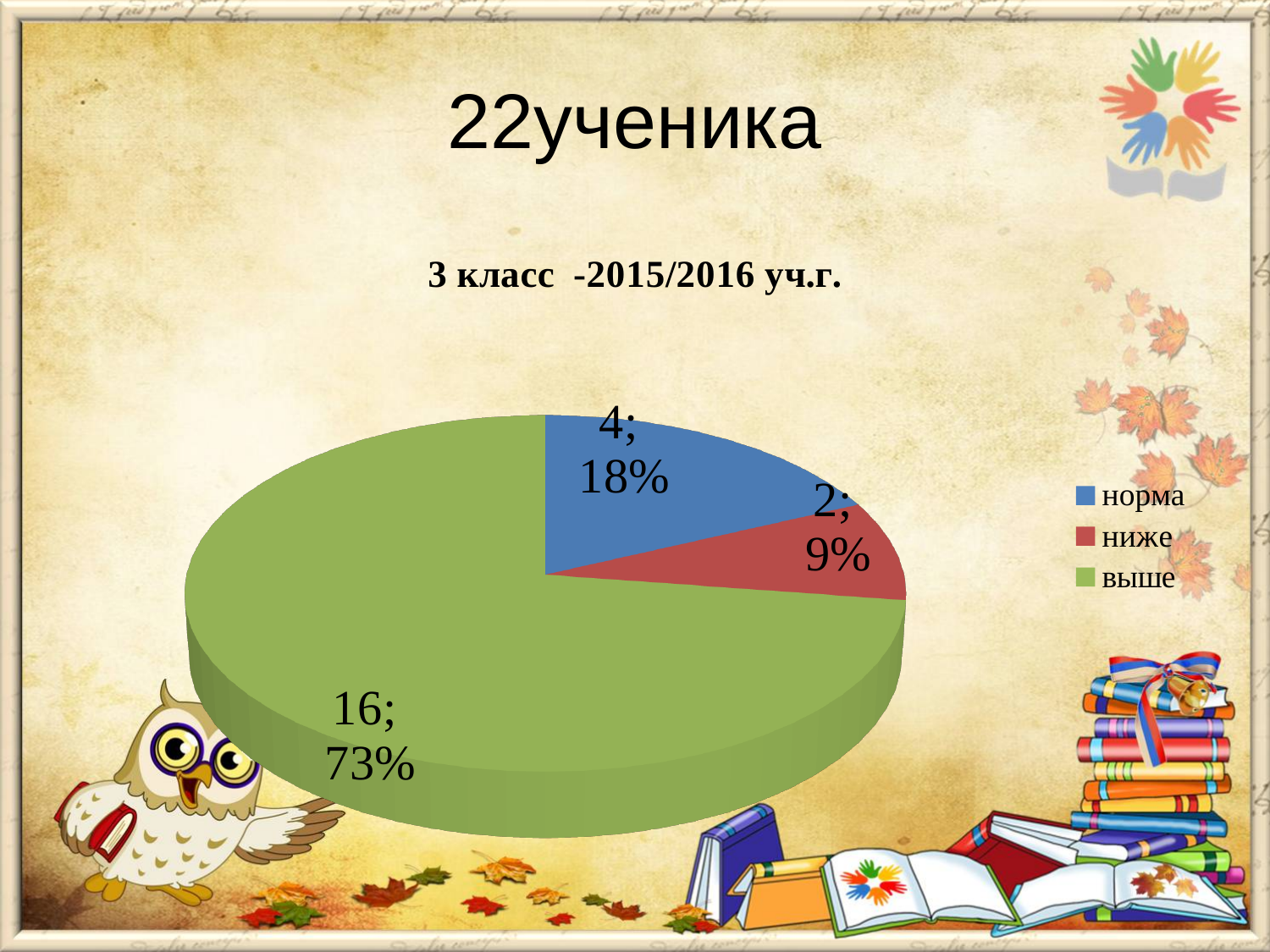
What share of the pie does выше take? 73% What kind of chart is shown on the slide? pie chart What is the difference between the values for выше and норма? 12 What is the value for ниже? 2 How many categories does the legend list? 3 What is the value for выше? 16 What is the title of the chart? 3 класс -2015/2016 уч.г. What is the value for норма? 4 Which category has the largest slice? выше Which category has the smallest slice? ниже How many slices does the pie chart have? 3 What share of the pie does норма take? 18%